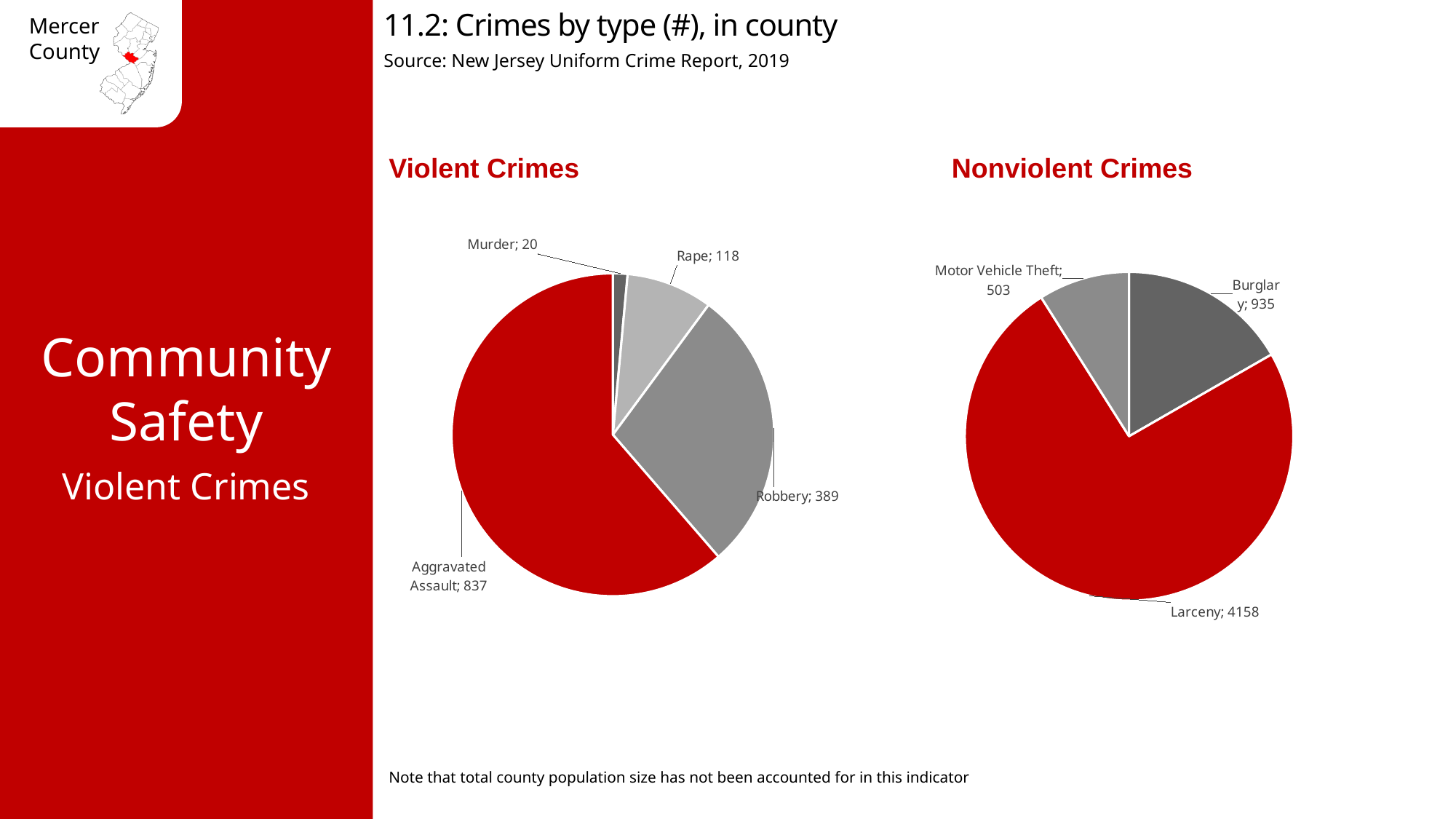
In the Violent Crimes pie chart, what is the value for Murder? 20 In the Nonviolent Crimes pie chart, which is larger, Burglary or Motor Vehicle Theft? Burglary In the Nonviolent Crimes pie chart, what is the value for Larceny? 4158 In the Violent Crimes pie chart, which crime type has the largest slice? Aggravated Assault In the Nonviolent Crimes pie chart, which crime type has the smallest slice? Motor Vehicle Theft In the Violent Crimes pie chart, how many aggravated assaults are shown? 837 In the Nonviolent Crimes pie chart, what is the value for Motor Vehicle Theft? 503 In the Nonviolent Crimes pie chart, what is the difference between Burglary and Motor Vehicle Theft? 432 In the Violent Crimes pie chart, what is the difference between Robbery and Rape? 271 How many crime types are shown in the Violent Crimes pie chart? 4 In the Violent Crimes pie chart, which crime type has the smallest slice? Murder What type of chart is used for Nonviolent Crimes? Pie chart